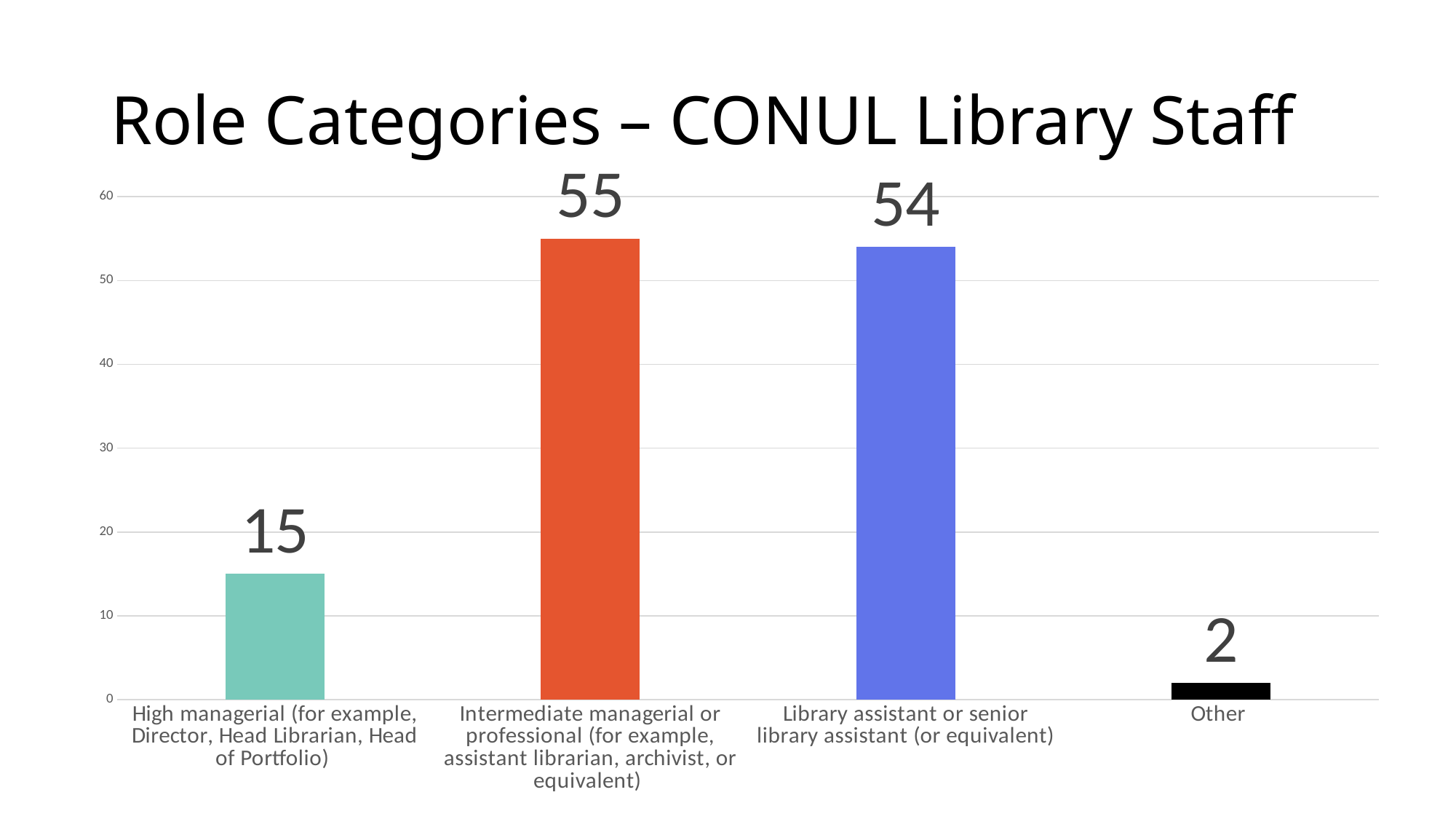
How many categories are shown in the chart? 4 Which category has the highest value? Intermediate managerial or professional Which category has the lowest value? Other What is the value for the Intermediate managerial or professional category? 55 Which is larger: the value for High managerial or the value for Other? High managerial What is the title of the slide? Role Categories – CONUL Library Staff What is the value for the High managerial category? 15 What kind of chart is shown on the slide? Bar chart What is the value for the Library assistant or senior library assistant category? 54 What is the difference between the Intermediate managerial or professional value and the High managerial value? 40 What is the difference between the Library assistant or senior library assistant value and the Other value? 52 What is the value for the Other category? 2